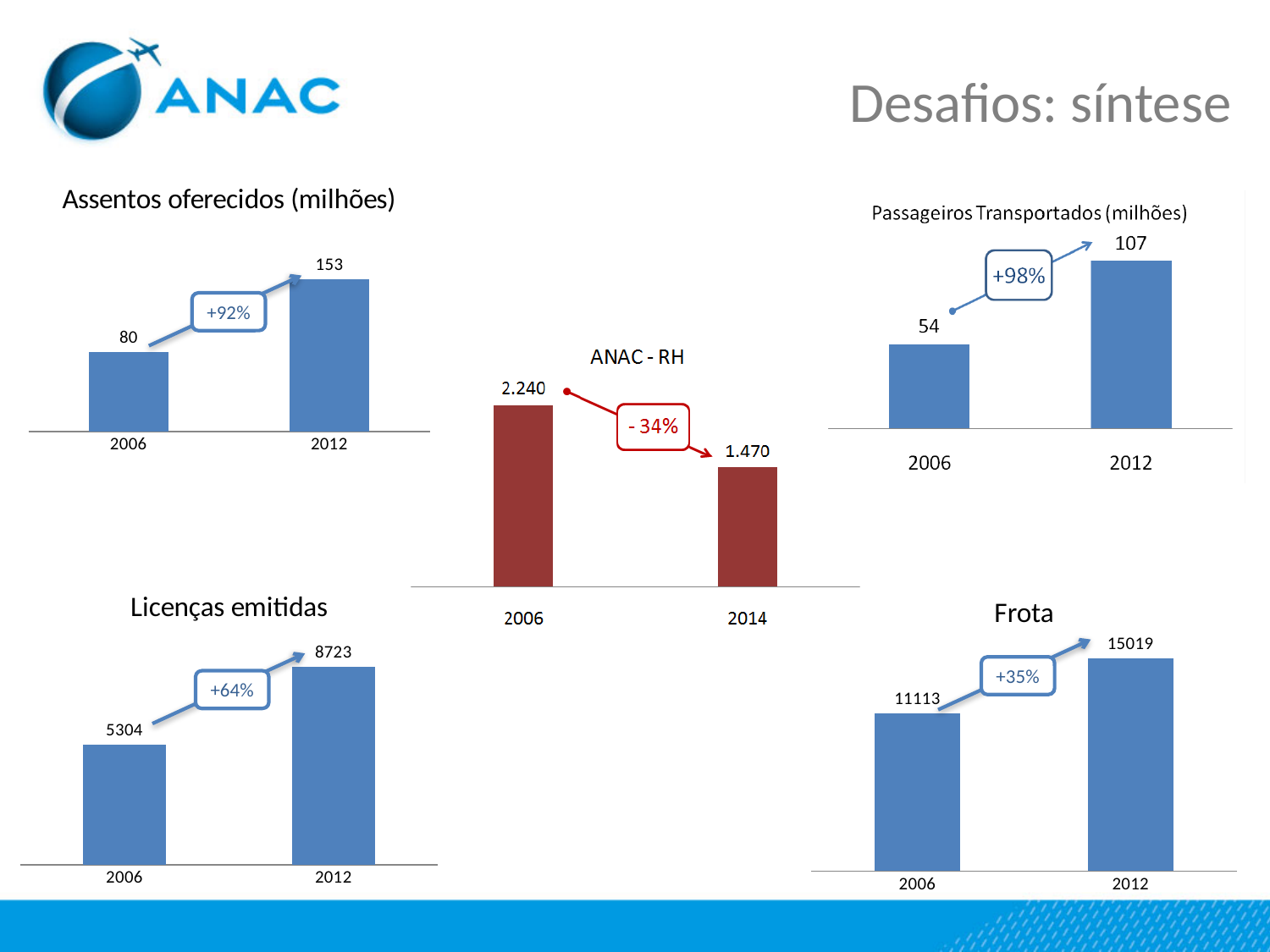
In the 'Passageiros Transportados (milhões)' chart, what is the value for 2006? 54 In the 'Assentos oferecidos (milhões)' chart, what is the value for 2012? 153 What kind of chart is the 'Frota' chart? bar chart In the 'ANAC - RH' chart, what is the value for 2006? 2.240 In the 'ANAC - RH' chart, do the values rise or fall from 2006 to 2014? fall In the 'Passageiros Transportados (milhões)' chart, which year has the higher value? 2012 In the 'Assentos oferecidos (milhões)' chart, what is the difference between the 2012 and 2006 values? 73 In the 'Licenças emitidas' chart, what is the value for 2012? 8723 In the 'Licenças emitidas' chart, what is the difference between the 2012 and 2006 values? 3419 In the 'Frota' chart, how many categories are shown on the x axis? 2 In the 'Frota' chart, what is the value for 2006? 11113 In the 'ANAC - RH' chart, which year has the lower value? 2014